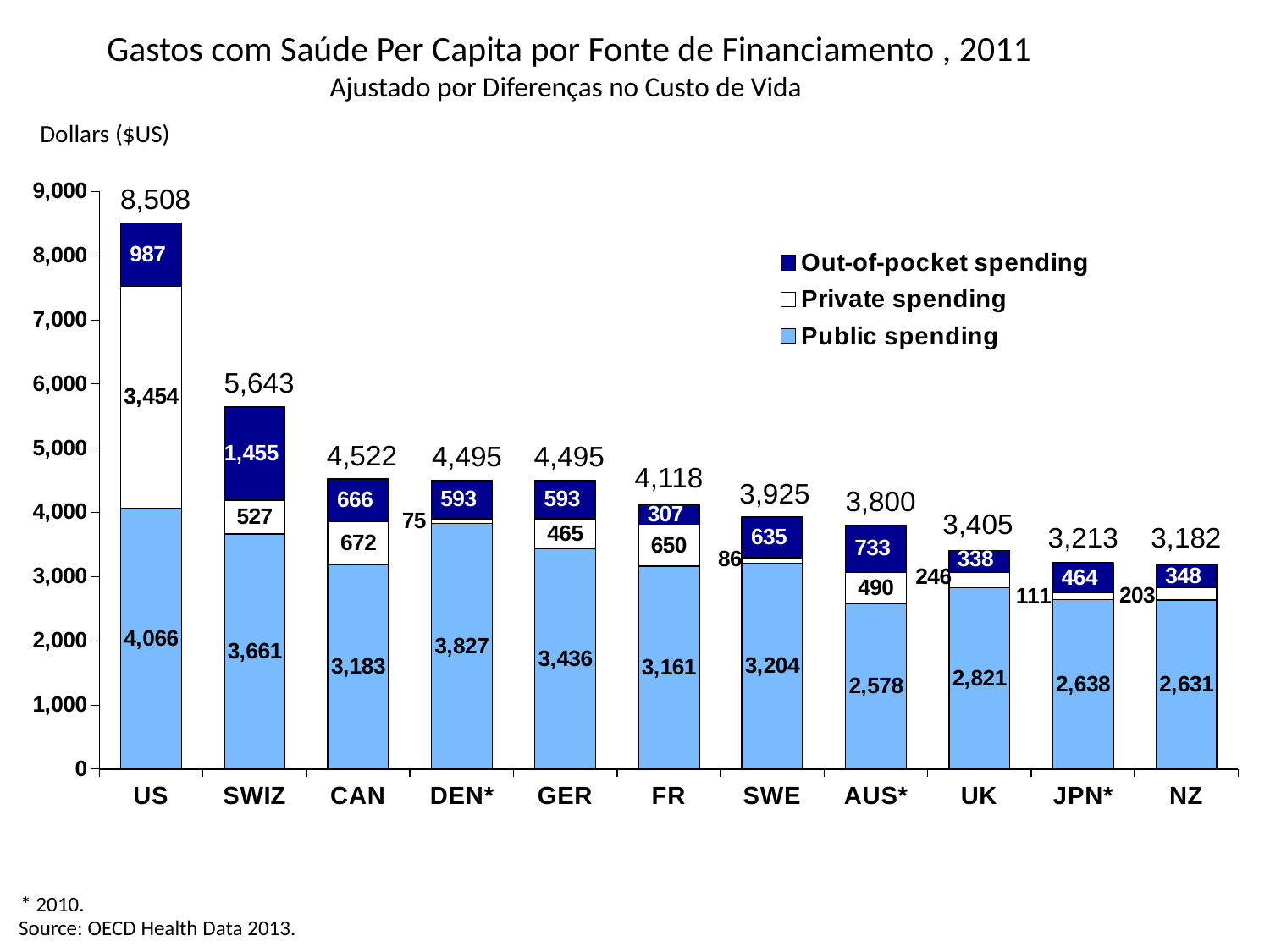
How many countries are shown on the x axis? 11 What is the out-of-pocket spending value for Switzerland (SWIZ)? 1,455 Do the total values rise or fall moving from left to right along the x axis? Fall How many series does the legend list? 3 What kind of chart is shown on the slide? Stacked bar chart Which country has the highest total per capita health spending? US What is the private spending value for Denmark (DEN*)? 75 What is the public spending value for Germany (GER)? 3,436 Which has higher public spending, Canada (CAN) or Sweden (SWE)? SWE Which country has the lowest total per capita health spending? NZ What is the total per capita health spending for the US? 8,508 What is the difference between the total spending of the US and Switzerland (SWIZ)? 2,865